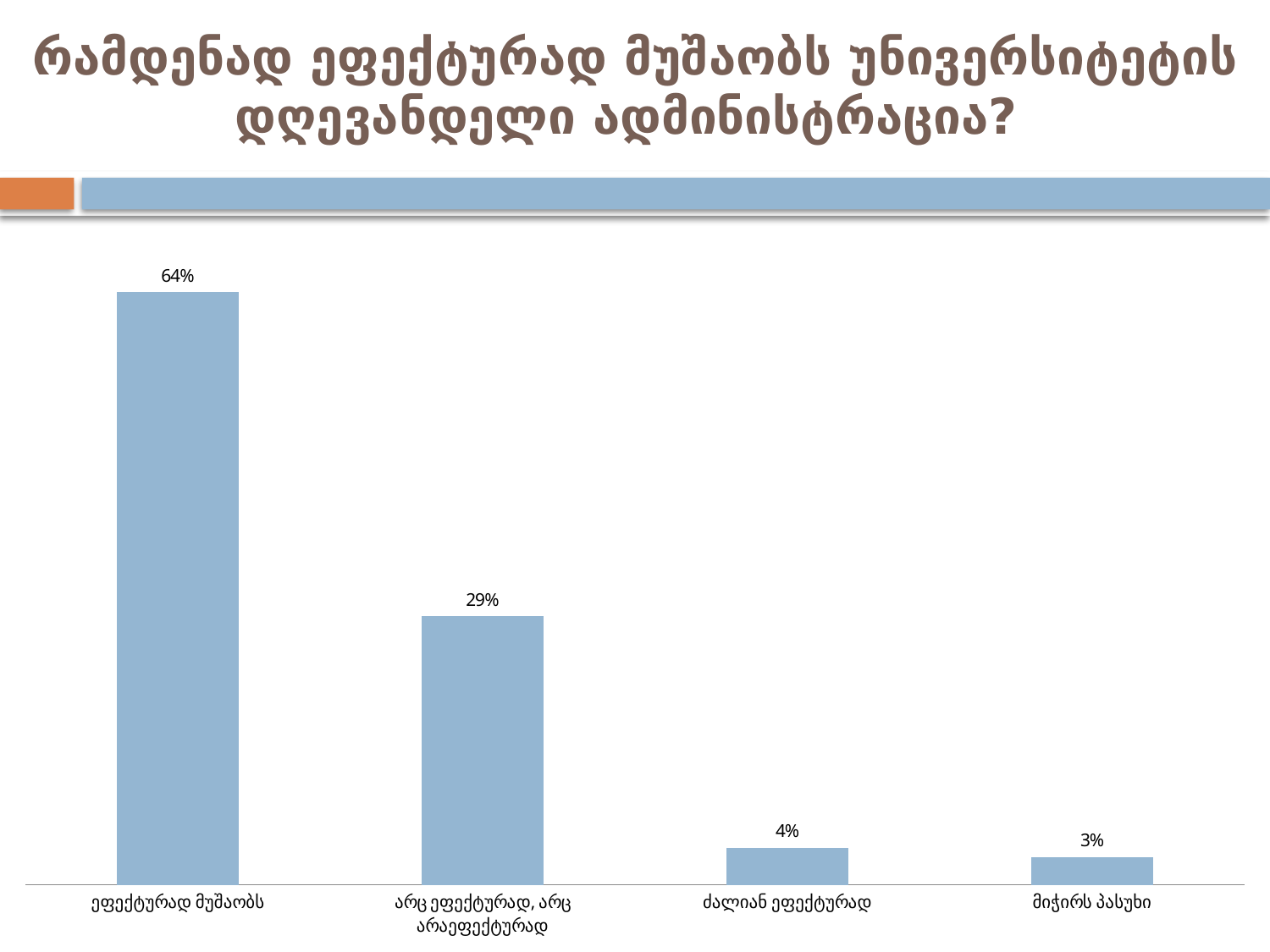
What kind of chart is shown on the slide? Bar chart What is the value for "არც ეფექტურად, არც არაეფექტურად"? 29% What is the value for "ეფექტურად მუშაობს"? 64% What is the difference between the values for "ძალიან ეფექტურად" and "მიჭირს პასუხი"? 1% What is the value for "მიჭირს პასუხი"? 3% Do the values rise or fall from left to right across the categories? Fall What is the difference between the values for "ეფექტურად მუშაობს" and "არც ეფექტურად, არც არაეფექტურად"? 35% Which is larger, the value for "არც ეფექტურად, არც არაეფექტურად" or the value for "ძალიან ეფექტურად"? არც ეფექტურად, არც არაეფექტურად Which category has the highest value? ეფექტურად მუშაობს Which category has the lowest value? მიჭირს პასუხი What is the value for "ძალიან ეფექტურად"? 4% How many categories are shown in the chart? 4